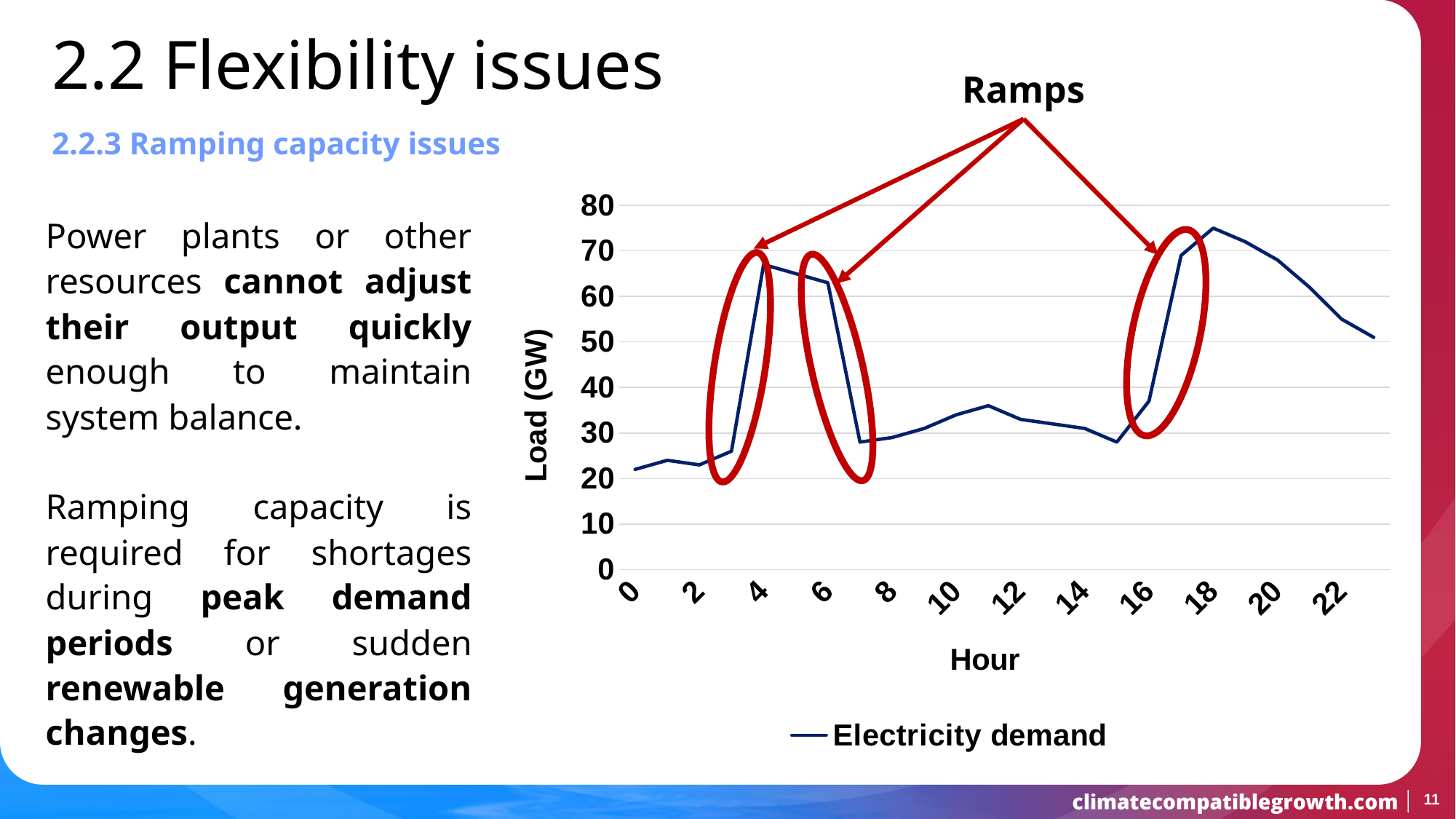
What is the label of the vertical axis of the chart? Load (GW) Is the electricity demand at hour 11 greater or less than 40? less What kind of chart is shown on the slide? line chart Is the electricity demand at hour 22 greater or less than 50? greater Which is larger, the electricity demand at hour 4 or at hour 11? hour 4 Does electricity demand rise or fall between hour 18 and hour 23? fall What is the name of the series shown in the chart legend? Electricity demand Is the electricity demand at hour 4 greater or less than 60? greater At which hour does electricity demand reach its highest value? 18 How many series does the chart legend list? 1